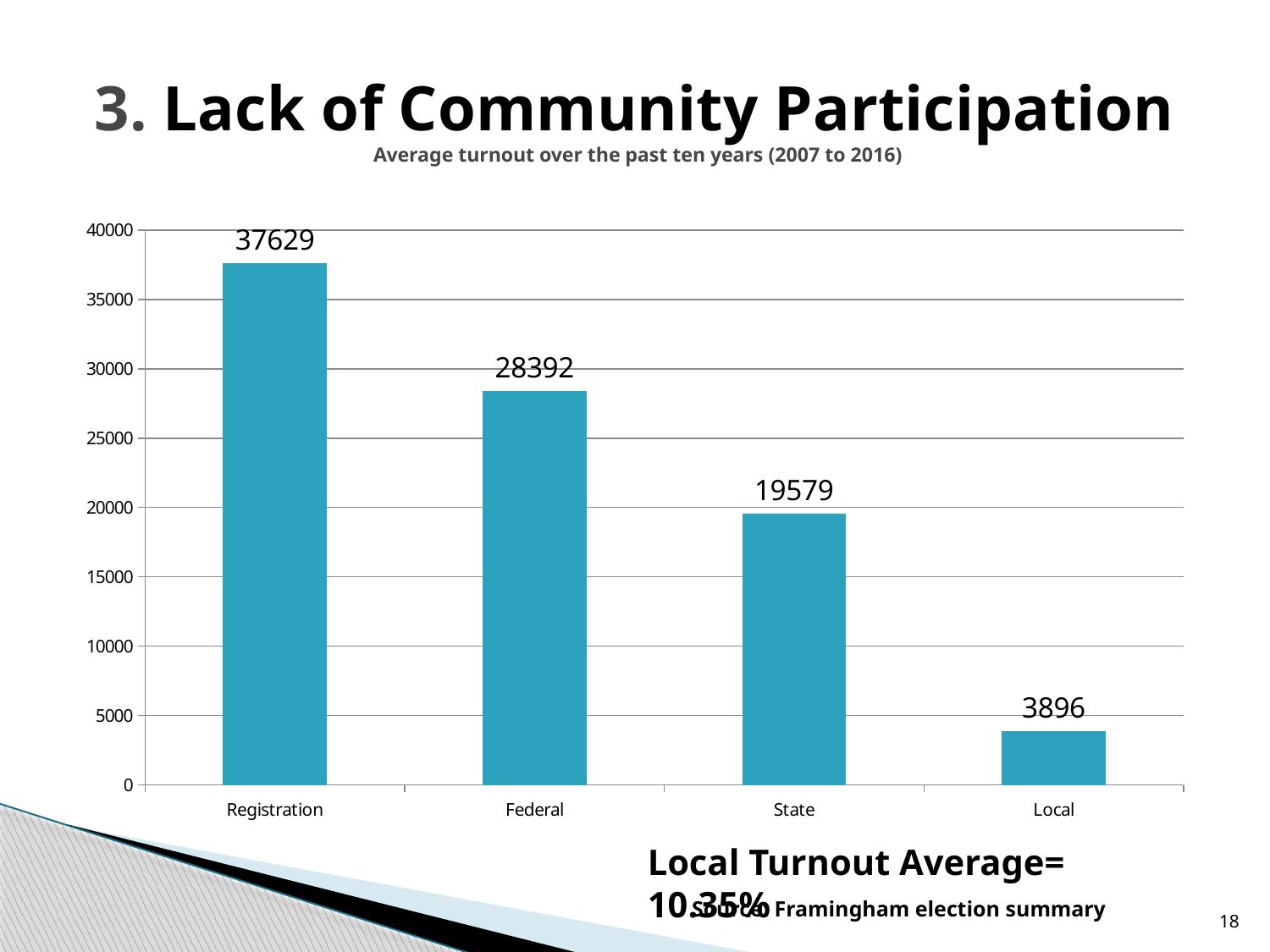
What is the value for Local? 3896 Which category has the highest value? Registration What is the difference between the Federal value and the State value? 8813 What is the value for State? 19579 Which is larger, the value for Federal or the value for State? Federal What kind of chart is shown on the slide? Bar chart What is the difference between the Registration value and the Local value? 33733 What is the value for Registration? 37629 Which category has the lowest value? Local How many categories are shown on the x axis? 4 Do the values rise or fall from left to right along the x axis? Fall What is the value for Federal? 28392